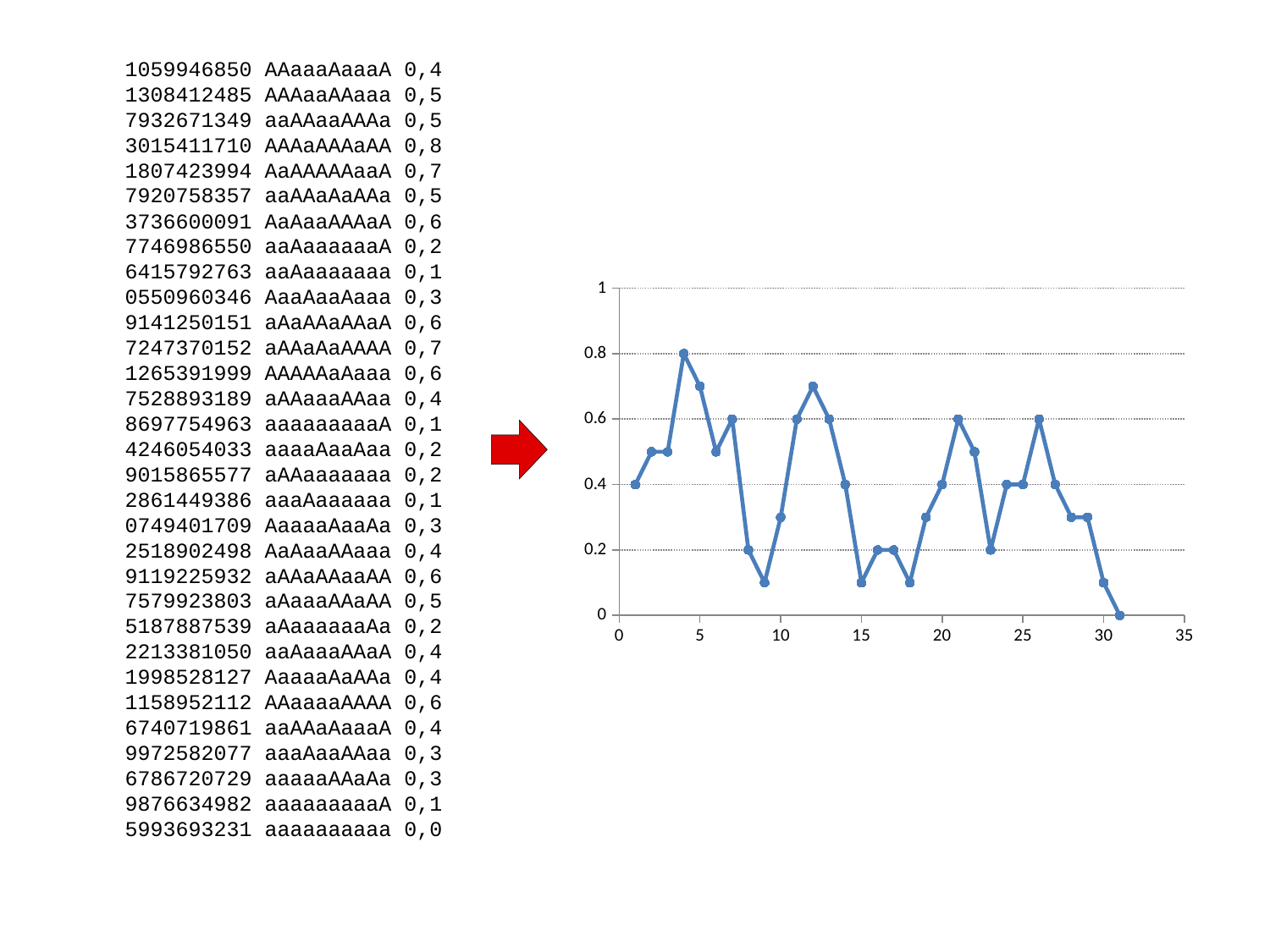
Is the value at x = 9 greater or less than 0.2? less Which is larger, the value at x = 4 or the value at x = 12? x = 4 At which x value does the line chart reach its highest point? 4 What is the value plotted at x = 31 on the line chart? 0 At which x value does the line chart reach its lowest point? 31 What is the value plotted at x = 21 on the line chart? 0.6 What is the difference between the value at x = 4 and the value at x = 1? 0.4 Is the value at x = 5 greater or less than 0.6? greater What is the value plotted at x = 1 on the line chart? 0.4 How many data points are plotted on the line chart? 31 What kind of chart is shown on the slide? line chart What is the highest value plotted on the line chart? 0.8